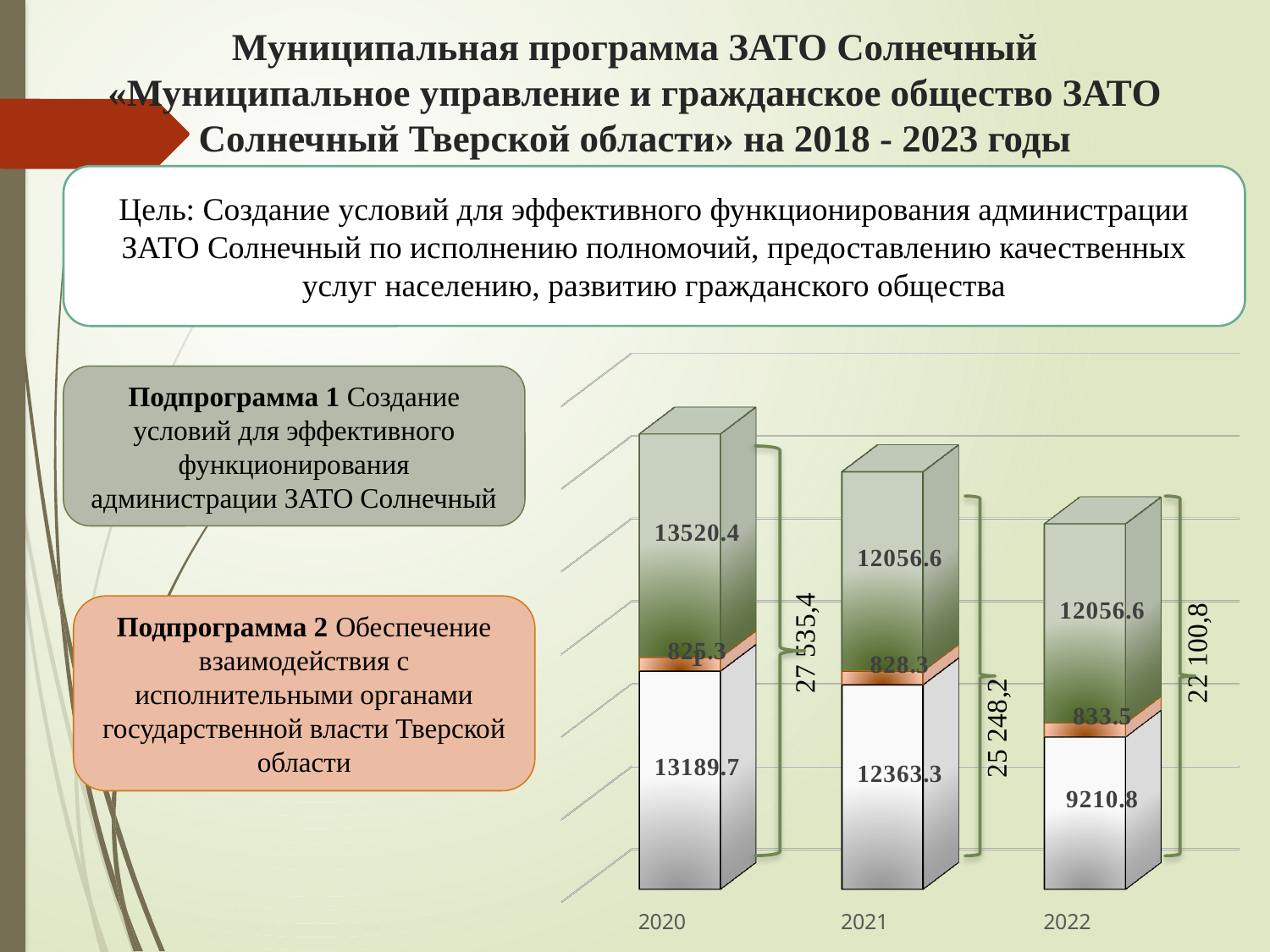
What total is shown next to the 2020 bar? 27 535,4 What is the difference between the bottom (white) segment values for 2020 and 2021? 826.4 Which year has the lowest value for the bottom (white) segment? 2022 How many years are shown on the x axis? 3 What is the value of the middle (orange) segment of the 2022 bar? 833.5 What is the value of the bottom (white) segment of the 2020 bar? 13189.7 Which is larger, the top (green) segment for 2020 or for 2022? 2020 What is the value of the top (green) segment of the 2021 bar? 12056.6 Do the bar totals rise or fall from 2020 to 2022? fall What is the difference between the top (green) segment values for 2020 and 2021? 1463.8 What total is shown next to the 2021 bar? 25 248,2 Which year has the highest total? 2020